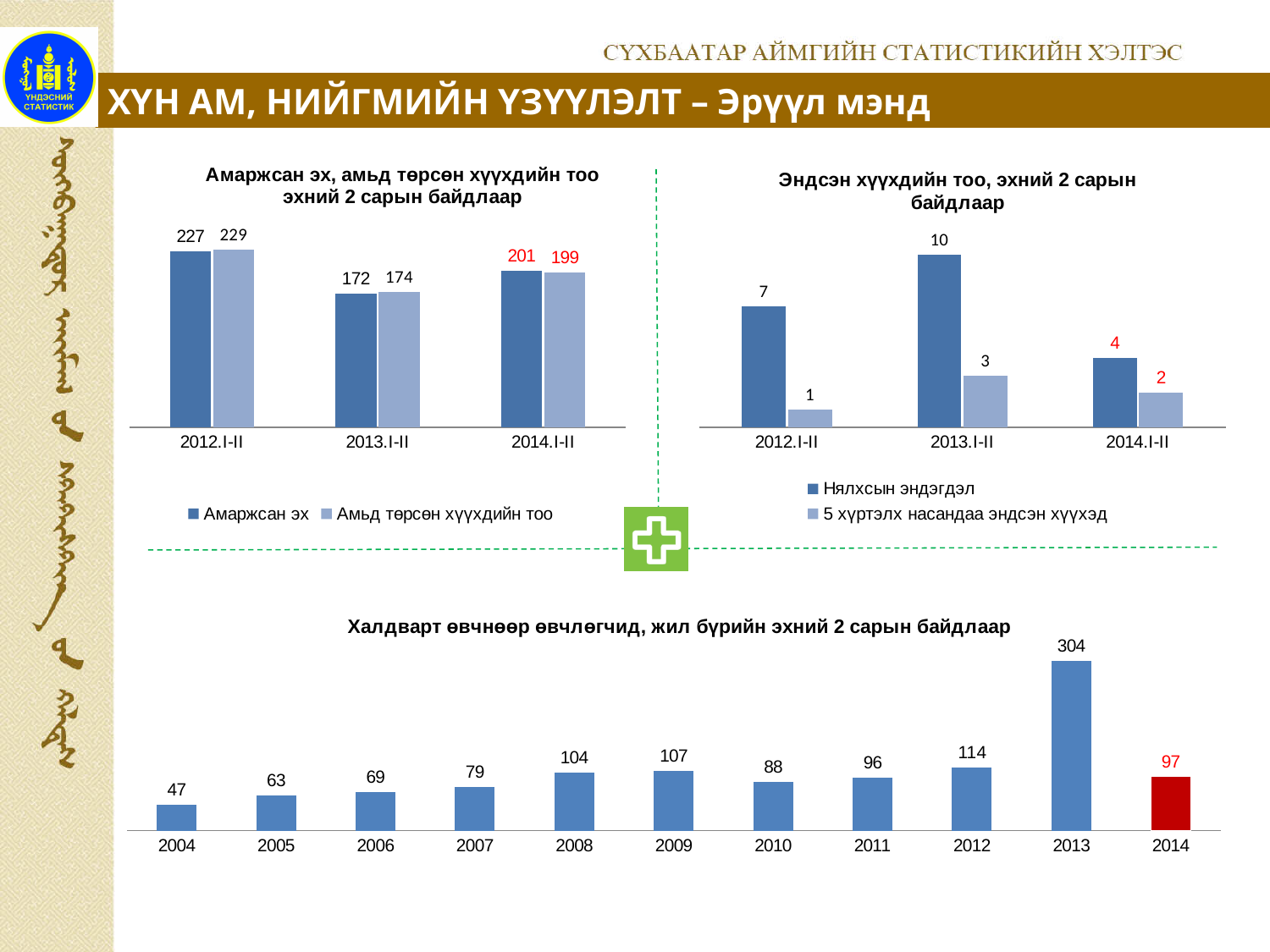
In the top-left chart (Амаржсан эх, амьд төрсөн хүүхдийн тоо), how many series does the legend list? 2 In the top-left chart (Амаржсан эх, амьд төрсөн хүүхдийн тоо), what is the value of Амьд төрсөн хүүхдийн тоо for 2014.I-II? 199 In the bottom chart (Халдварт өвчнөөр өвчлөгчид), what is the value for 2009? 107 In the bottom chart (Халдварт өвчнөөр өвчлөгчид), which year has the highest value? 2013 In the top-right chart (Эндсэн хүүхдийн тоо), what is the value of Нялхсын эндэгдэл for 2013.I-II? 10 In the top-left chart (Амаржсан эх, амьд төрсөн хүүхдийн тоо), what is the difference between Амьд төрсөн хүүхдийн тоо and Амаржсан эх in 2012.I-II? 2 In the top-right chart (Эндсэн хүүхдийн тоо), what is the difference between Нялхсын эндэгдэл and 5 хүртэлх насандаа эндсэн хүүхэд in 2014.I-II? 2 In the bottom chart (Халдварт өвчнөөр өвчлөгчид), which year has the lowest value? 2004 In the top-right chart (Эндсэн хүүхдийн тоо), which period has the lowest value for 5 хүртэлх насандаа эндсэн хүүхэд? 2012.I-II In the bottom chart (Халдварт өвчнөөр өвчлөгчид), how many years are shown on the x axis? 11 In the bottom chart (Халдварт өвчнөөр өвчлөгчид), what is the difference between the values for 2013 and 2014? 207 In the top-left chart (Амаржсан эх, амьд төрсөн хүүхдийн тоо), what is the value of Амаржсан эх for 2013.I-II? 172